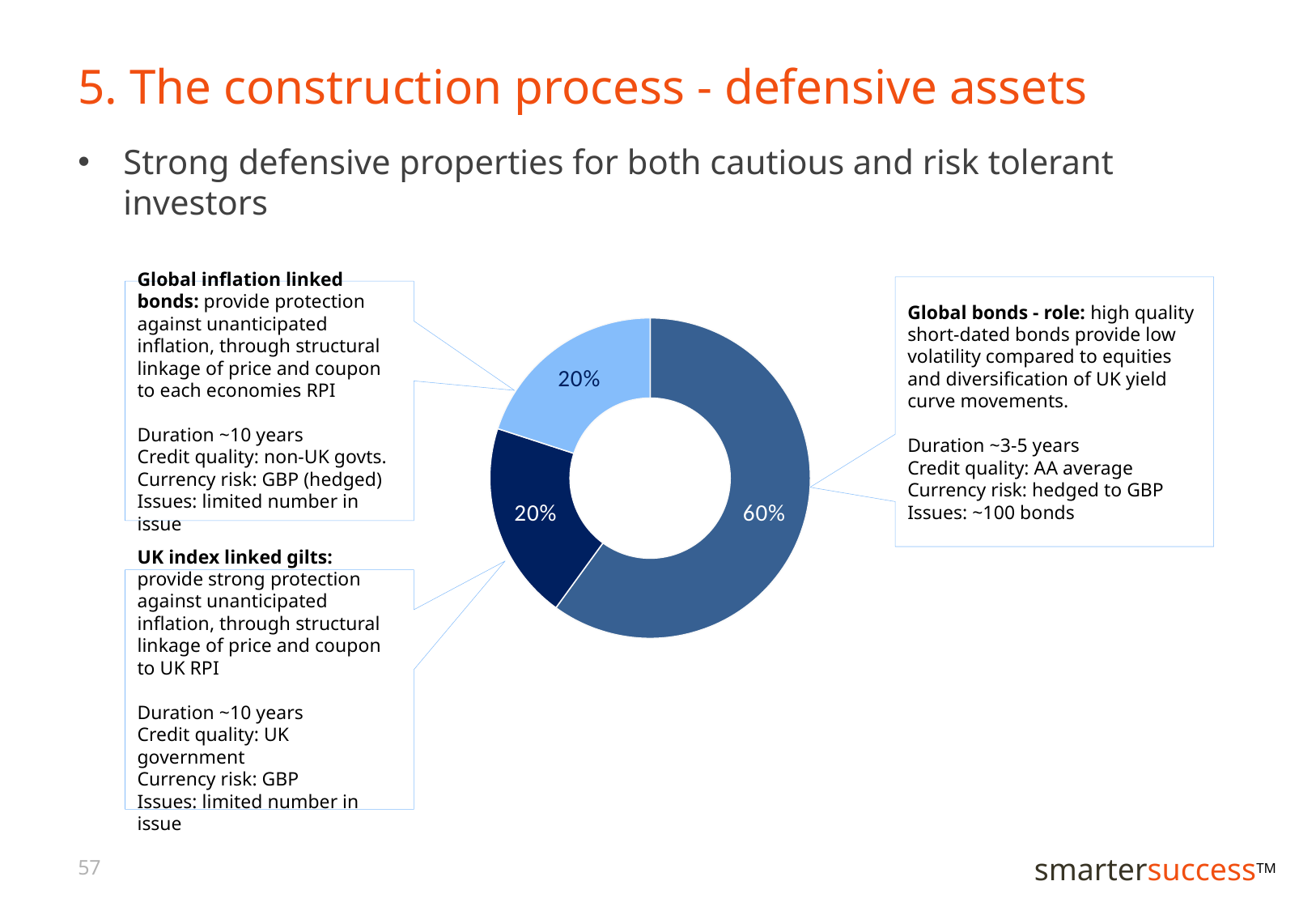
What percentage of the doughnut chart is Global inflation linked bonds? 20% What kind of chart is shown on the slide? Doughnut chart How many percentage points larger is the Global bonds slice than the UK index linked gilts slice? 40 percentage points What is the combined share of the UK index linked gilts and Global inflation linked bonds slices? 40% What percentage of the doughnut chart is UK index linked gilts? 20% Is the Global bonds share greater or less than 50%? greater Which is larger: the Global bonds slice or the Global inflation linked bonds slice? Global bonds What share of the doughnut chart is allocated to Global bonds? 60% How many slices does the doughnut chart have? 3 How many slices in the doughnut chart are labelled 20%? 2 Which asset class has the largest slice in the doughnut chart? Global bonds Which asset class is shown by the dark navy slice of the doughnut chart? UK index linked gilts